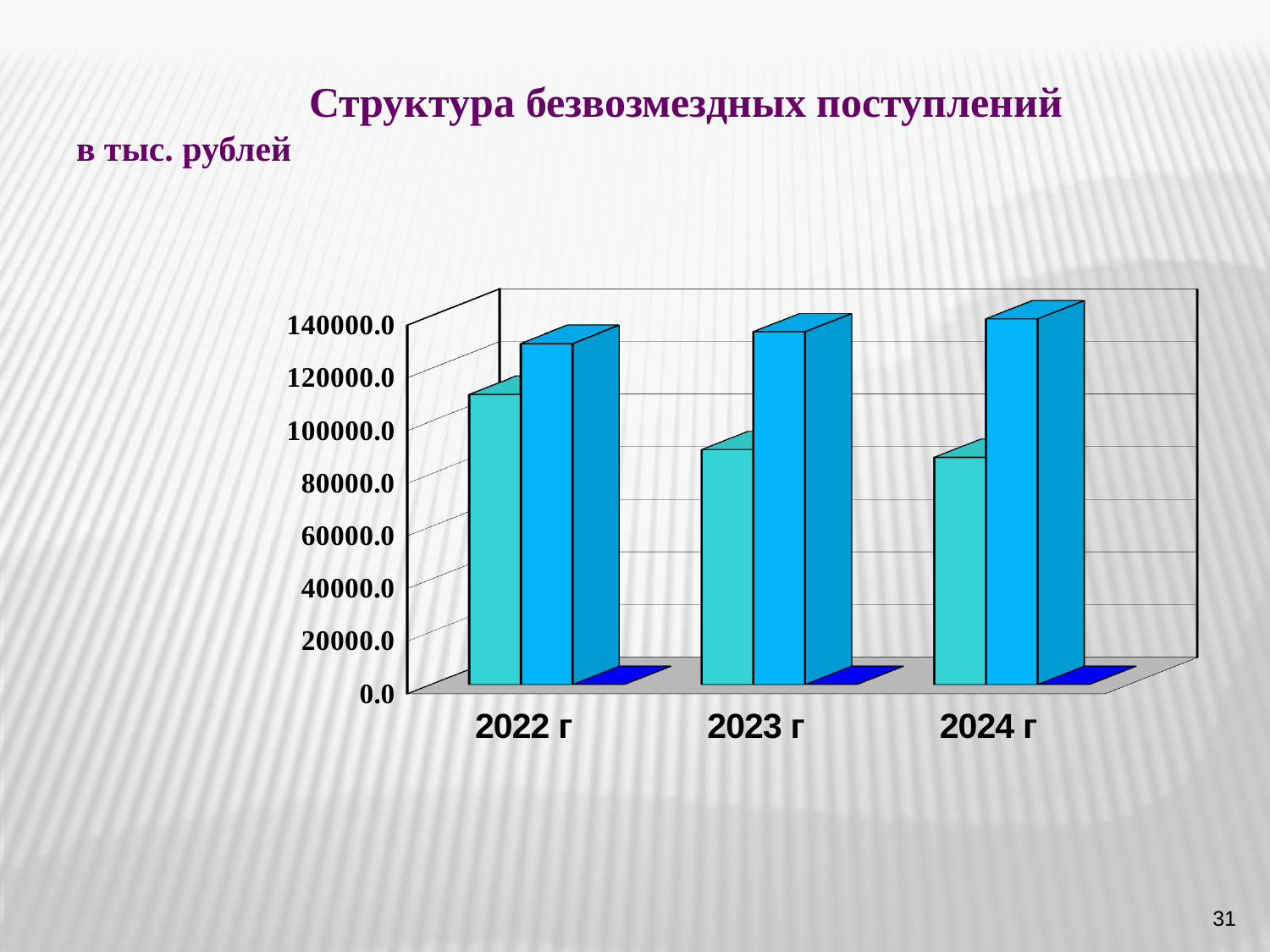
What is the title of the chart? Структура безвозмездных поступлений Is the value of the blue (right) bar for 2022 г greater or less than 120000.0? greater Do the values of the blue (right) bars rise or fall from 2022 г to 2024 г? rise Is the value of the teal (left) bar for 2023 г greater or less than 100000.0? less For 2022 г, which is larger: the teal (left) bar or the blue (right) bar? the blue (right) bar Is the value of the teal (left) bar for 2022 г greater or less than 100000.0? greater In what units are the values on the chart given, according to the slide? в тыс. рублей What kind of chart is shown on the slide? bar chart Do the values of the teal (left) bars rise or fall from 2022 г to 2024 г? fall How many years are shown on the x axis of the chart? 3